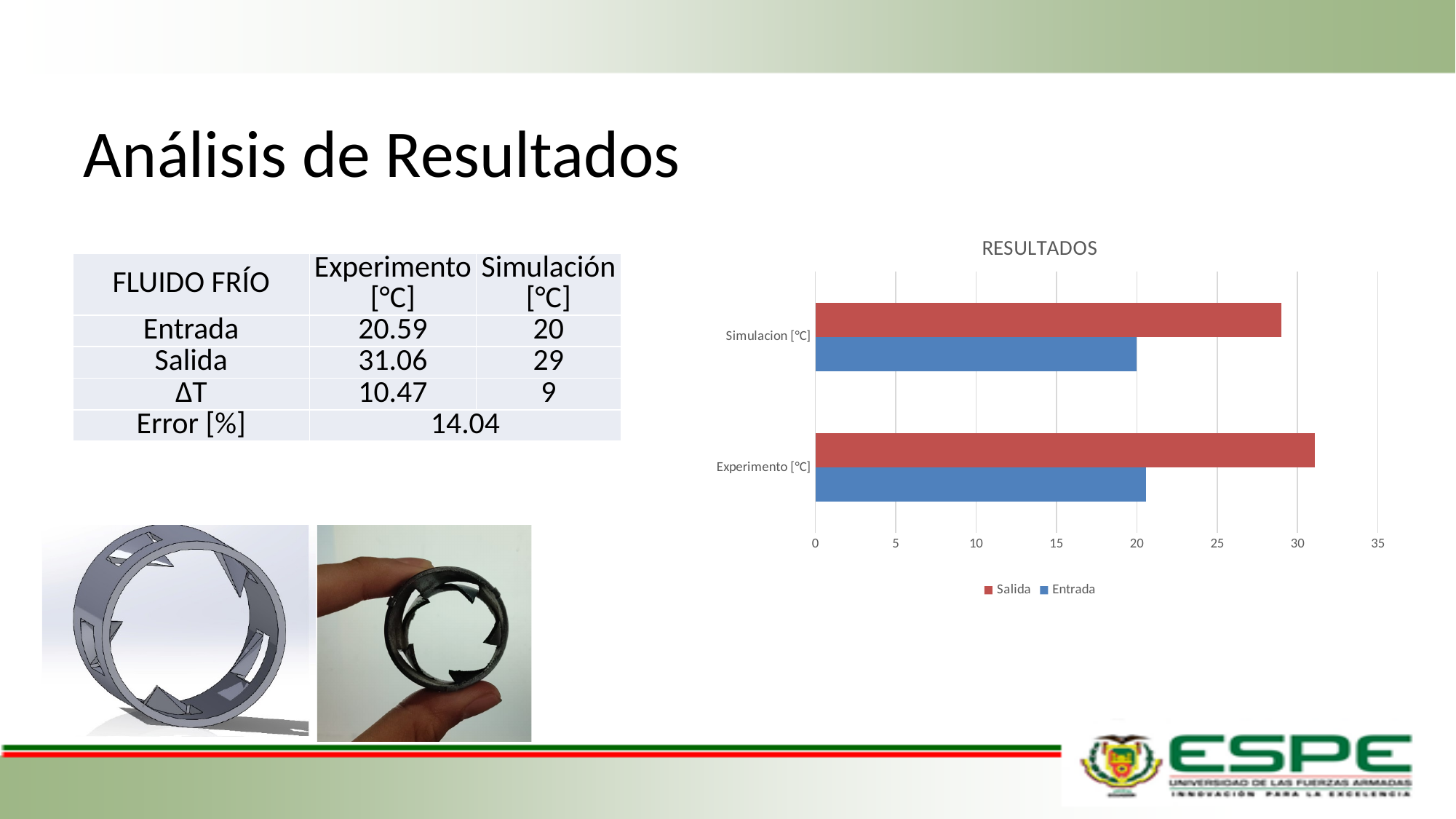
What is the Entrada value for Simulacion [°C] in the chart? 20 How many categories are shown on the y axis of the RESULTADOS chart? 2 How many series does the legend of the RESULTADOS chart list? 2 For Experimento [°C], which series has the larger value, Salida or Entrada? Salida Which category has the larger Salida value, Experimento [°C] or Simulacion [°C]? Experimento [°C] Which category has the highest Salida bar in the chart? Experimento [°C] What is the title of the chart? RESULTADOS Is the Salida value for Experimento [°C] greater or less than 30? greater Is the Salida value for Simulacion [°C] greater or less than 30? less Is the Entrada value for Experimento [°C] greater or less than 25? less What are the two legend entries of the chart? Salida and Entrada What kind of chart is shown on the slide? bar chart